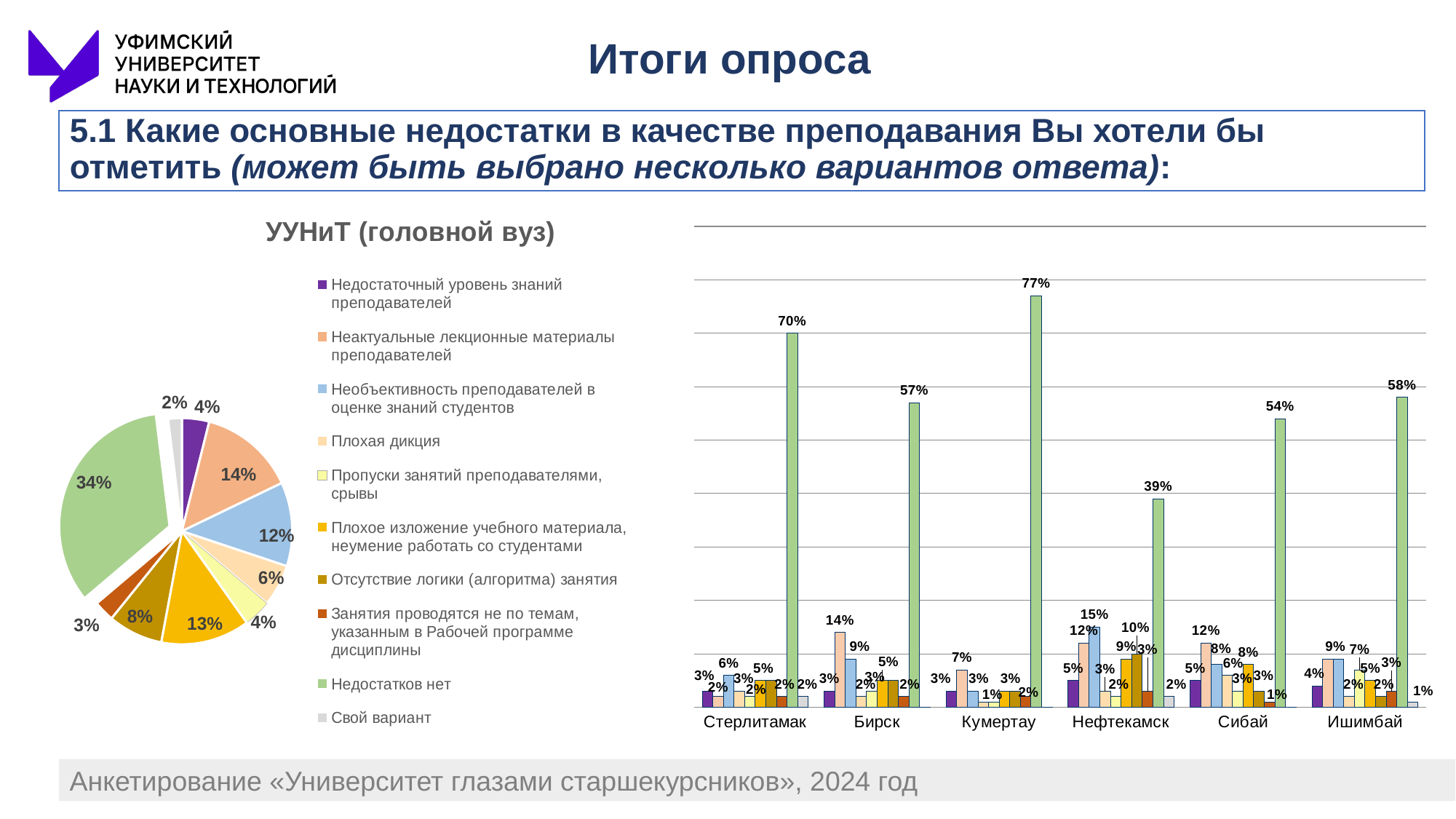
What type of chart is shown on the right side of the slide? Bar chart In the bar chart on the right, what is the difference between the tallest bars for Стерлитамак and Бирск? 13% In the bar chart on the right, which city has the lowest value among the tallest (green) bars? Нефтекамск In the bar chart on the right, what is the value of the tallest bar for Кумертау? 77% In the pie chart titled «УУНиТ (головной вуз)», how many categories does the legend list? 10 In the pie chart titled «УУНиТ (головной вуз)», what is the difference between «Плохое изложение учебного материала, неумение работать со студентами» and «Отсутствие логики (алгоритма) занятия»? 5% In the pie chart titled «УУНиТ (головной вуз)», what is the value for «Неактуальные лекционные материалы преподавателей»? 14% In the bar chart on the right, which city has the highest value among the tallest (green) bars? Кумертау In the pie chart titled «УУНиТ (головной вуз)», which category has the largest slice? Недостатков нет In the bar chart on the right, how many cities are shown on the x axis? 6 In the pie chart titled «УУНиТ (головной вуз)», what share does «Недостатков нет» have? 34% In the pie chart titled «УУНиТ (головной вуз)», which category has the smallest slice? Свой вариант